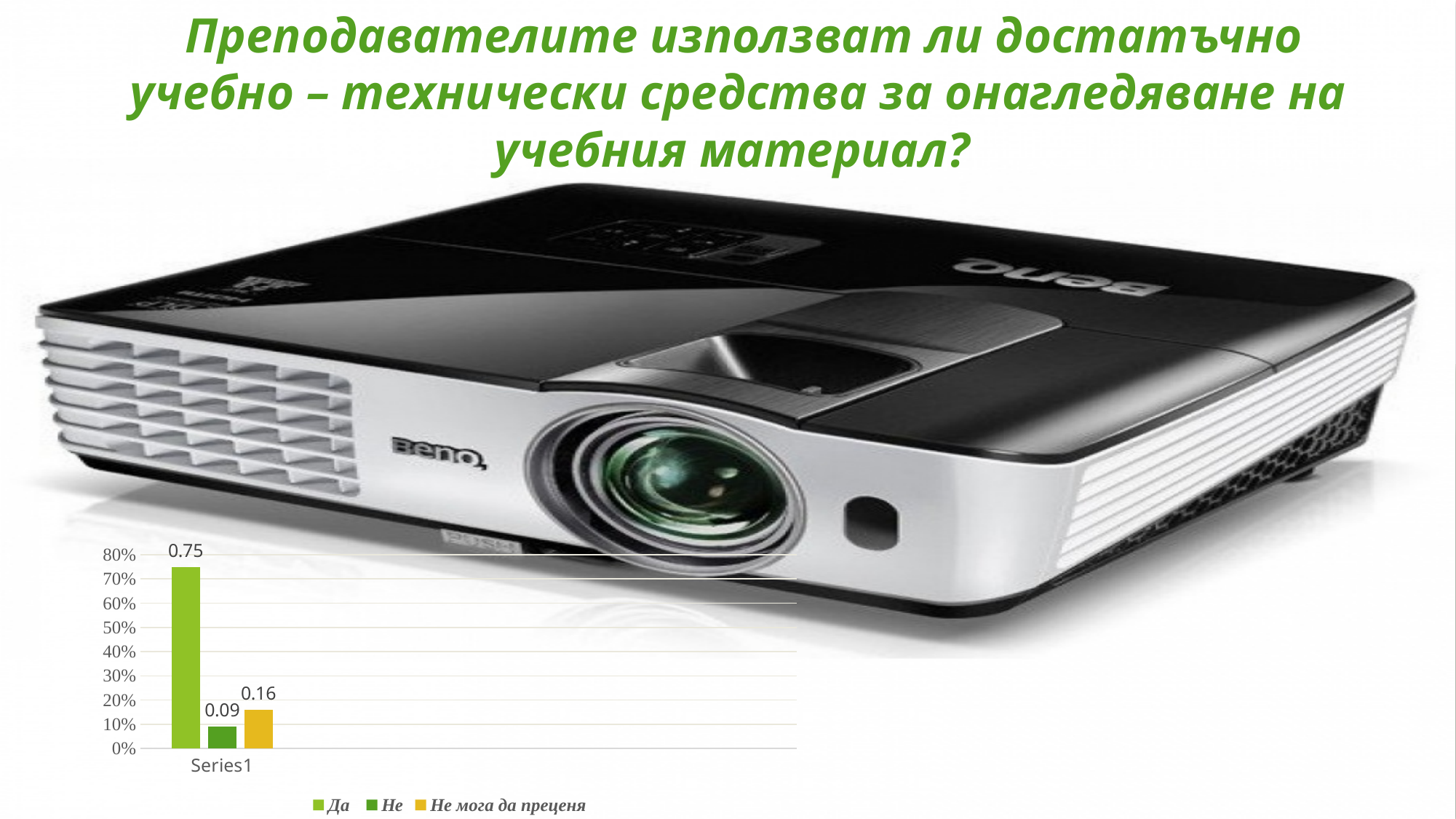
What is the category label shown on the x axis of the chart? Series1 How many series does the legend list? 3 What is the difference between the values for "Да" and "Не"? 0.66 What kind of chart is shown on the slide? bar chart What is the value shown for "Не" in the chart? 0.09 Which series has the lowest value in the chart? Не What is the difference between the values for "Не мога да преценя" and "Не"? 0.07 What is the value shown for "Да" in the chart? 0.75 Which series has the highest value in the chart? Да Which is larger, the value for "Не" or the value for "Не мога да преценя"? Не мога да преценя Is the value for "Да" greater or less than 50%? greater What is the value shown for "Не мога да преценя" in the chart? 0.16